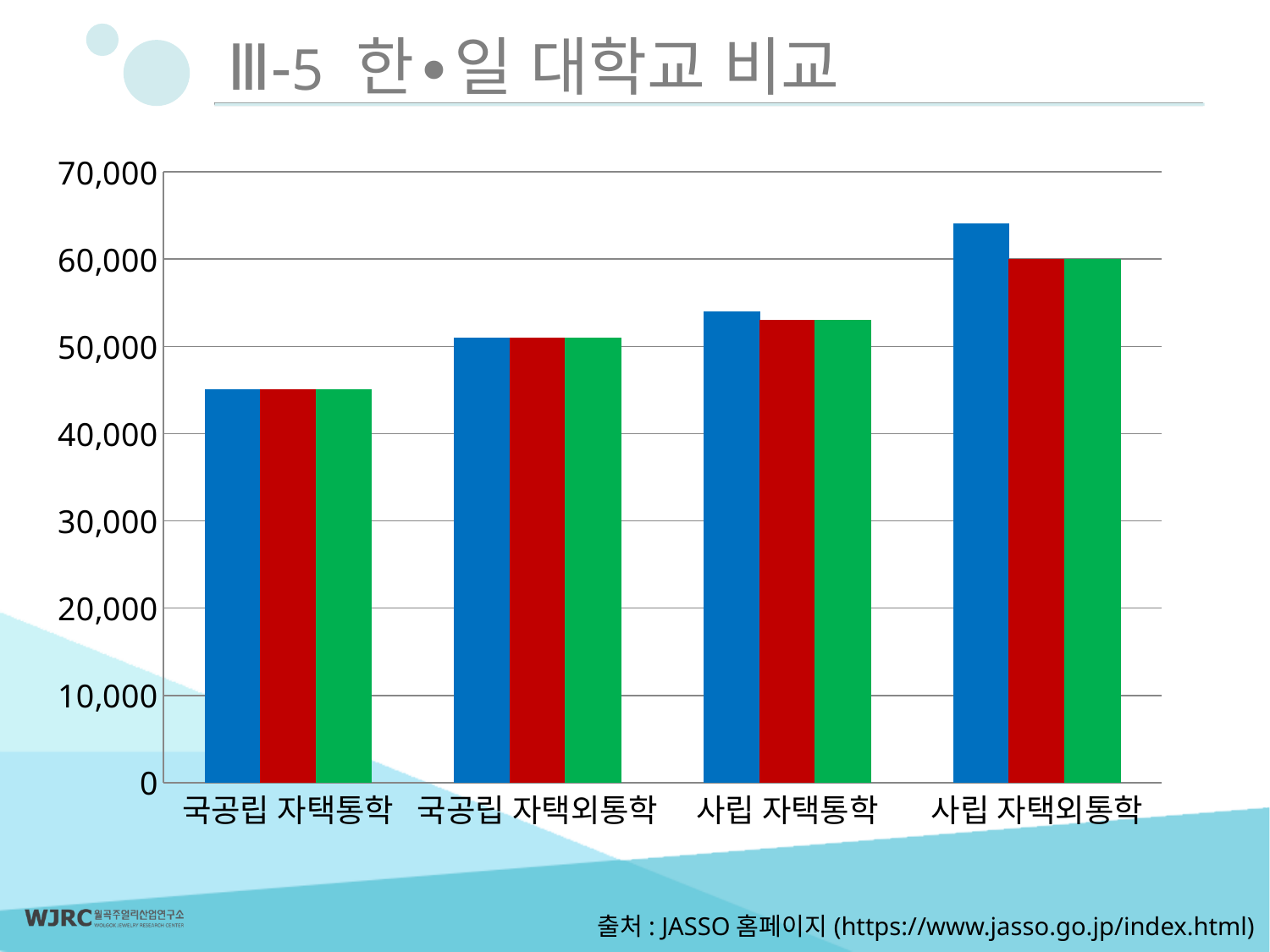
Is the value of the blue bar for 국공립 자택통학 greater or less than 50,000? less What is the title of the slide containing the chart? Ⅲ-5 한•일 대학교 비교 Is the value of the green bar for 국공립 자택외통학 greater or less than 60,000? less Is the value of the blue bar for 사립 자택통학 greater or less than 50,000? greater Which category has the highest bars in the chart? 사립 자택외통학 How many categories are shown on the x axis of the chart? 4 Do the bar values generally rise or fall from left to right across the categories? rise What kind of chart is shown on the slide? bar chart Which is larger, the blue bar for 사립 자택외통학 or the blue bar for 사립 자택통학? 사립 자택외통학 How many bars are shown for each category in the chart? 3 Which category has the lowest bars in the chart? 국공립 자택통학